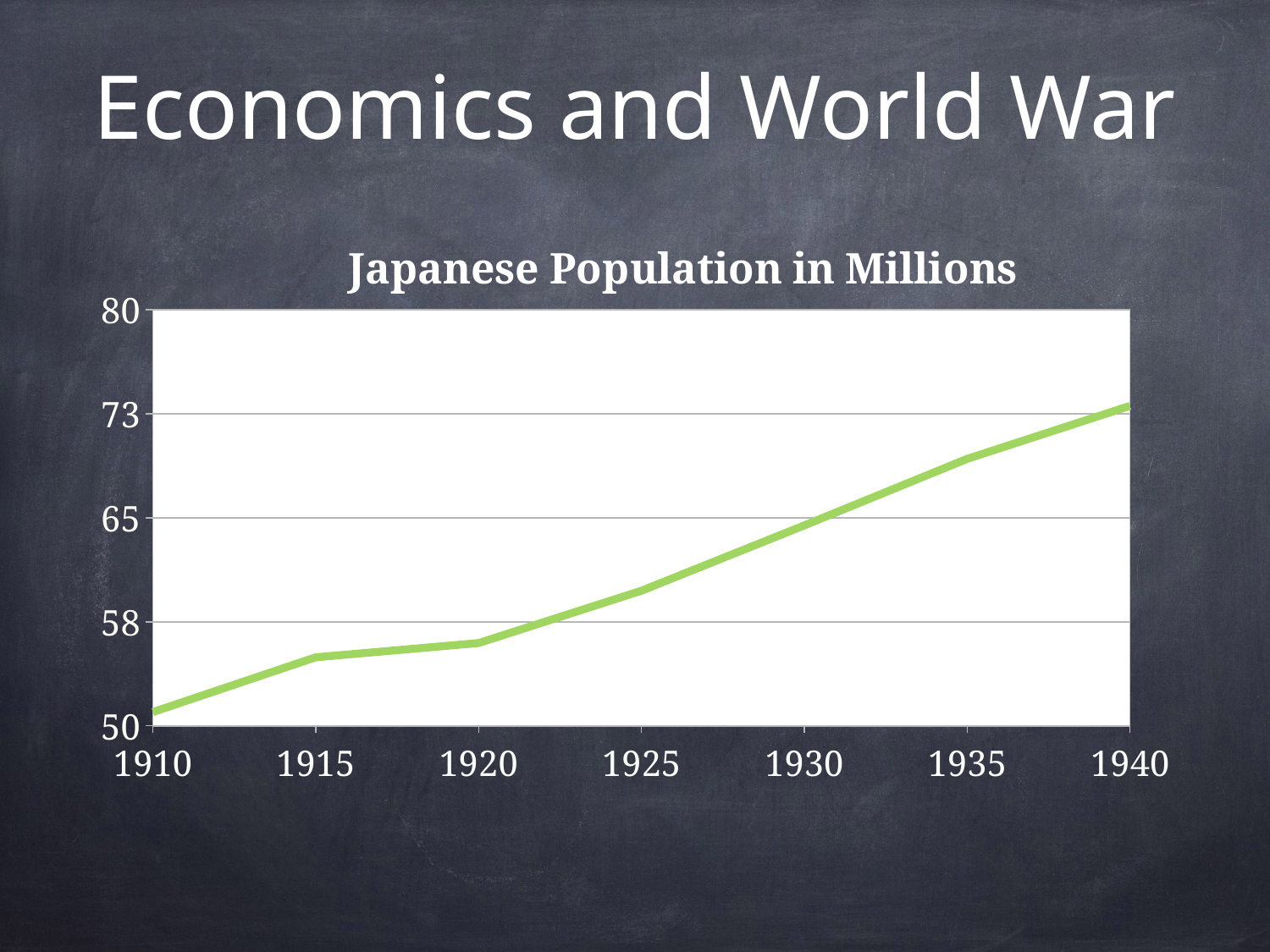
Is the value for 1925 greater or less than 58? greater Is the value for 1910 greater or less than 58? less Is the value for 1935 greater or less than 65? greater Which year has the lowest Japanese population in the chart? 1910 What is the title of the chart? Japanese Population in Millions Which year has the highest Japanese population in the chart? 1940 Which is larger, the value for 1915 or the value for 1935? 1935 Do the values rise or fall from 1910 to 1940? rise What kind of chart is shown on the slide? line chart How many years are plotted along the x axis of the chart? 7